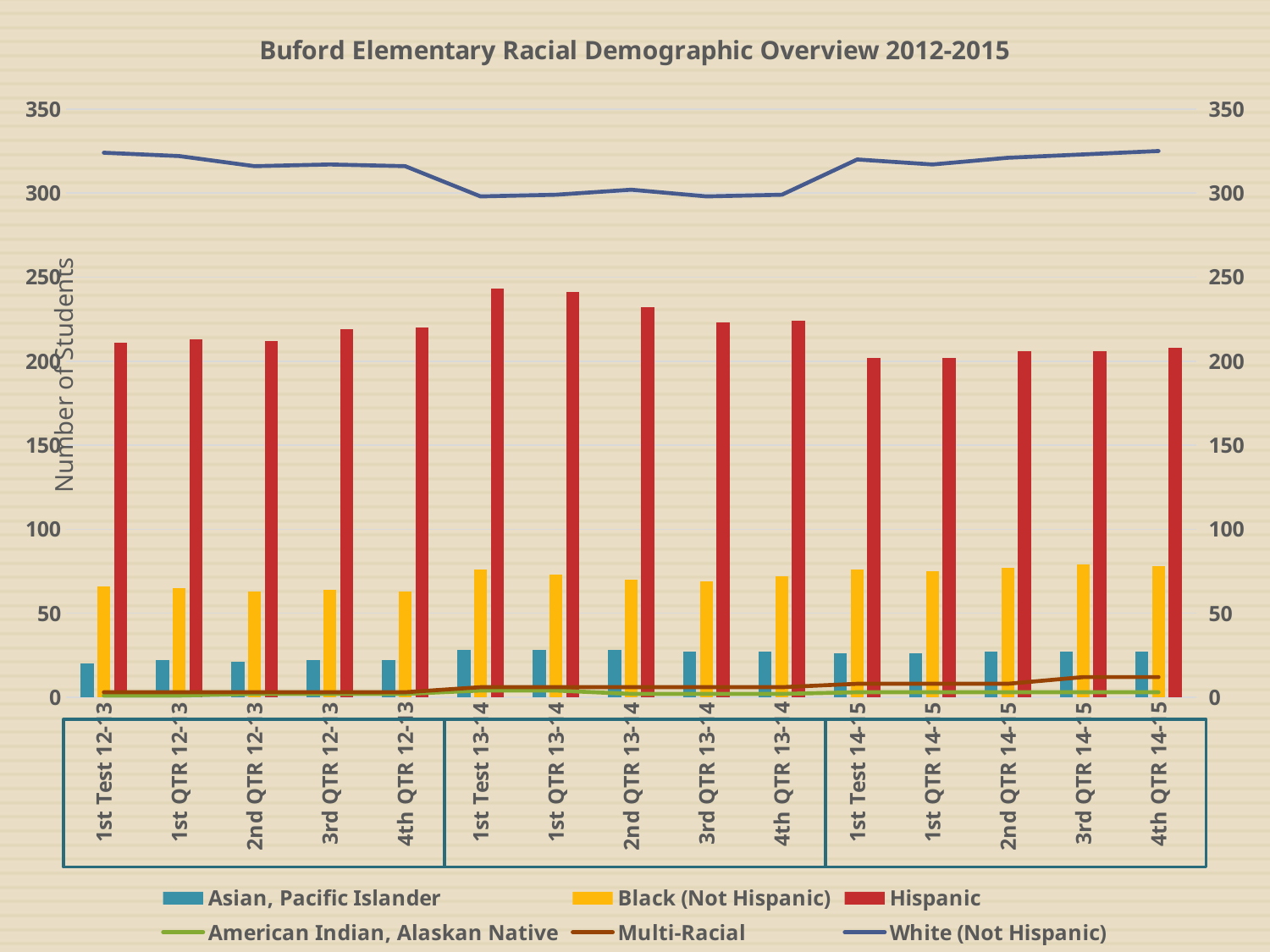
What is the title of the chart? Buford Elementary Racial Demographic Overview 2012-2015 Is the Black (Not Hispanic) value for 1st Test 12-13 greater or less than 50? greater Which is larger, the Hispanic value for 1st Test 13-14 or the Hispanic value for 1st Test 14-15? 1st Test 13-14 How many series does the legend list? 6 What is the label on the vertical axis? Number of Students Does the White (Not Hispanic) line rise or fall from 1st Test 12-13 to 1st Test 13-14? fall Which is larger, the White (Not Hispanic) value for 1st Test 12-13 or the White (Not Hispanic) value for 1st Test 13-14? 1st Test 12-13 What kind of chart is shown on the slide? A combined bar and line chart Is the Hispanic value for 1st Test 12-13 greater or less than 200? greater Is the Asian, Pacific Islander value for 1st Test 12-13 greater or less than 50? less How many categories are shown along the x axis? 15